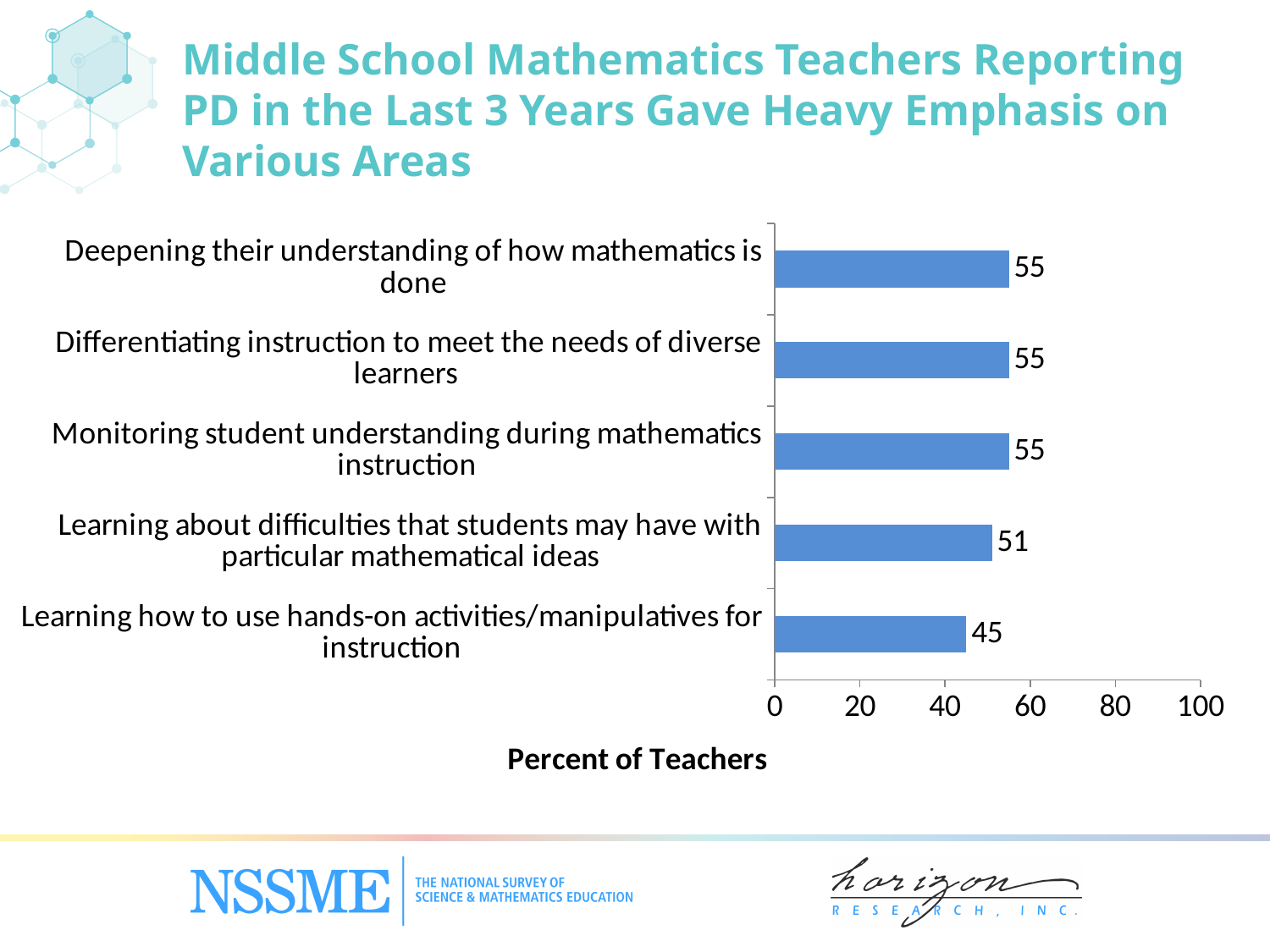
How many areas are shown in the chart? 5 Which area has the lowest percent of teachers? Learning how to use hands-on activities/manipulatives for instruction Is the value for learning how to use hands-on activities/manipulatives for instruction greater or less than 60? less What kind of chart is shown on the slide? Bar chart What is the difference between the value for differentiating instruction to meet the needs of diverse learners and the value for learning how to use hands-on activities/manipulatives for instruction? 10 What percent of teachers reported heavy emphasis on learning how to use hands-on activities/manipulatives for instruction? 45 What is the difference between the value for monitoring student understanding during mathematics instruction and the value for learning about difficulties that students may have with particular mathematical ideas? 4 What percent of teachers reported heavy emphasis on monitoring student understanding during mathematics instruction? 55 What is the value for learning about difficulties that students may have with particular mathematical ideas? 51 What is the label of the horizontal axis? Percent of Teachers Which is larger: the value for learning about difficulties that students may have with particular mathematical ideas or the value for learning how to use hands-on activities/manipulatives for instruction? Learning about difficulties that students may have with particular mathematical ideas What is the value for deepening their understanding of how mathematics is done? 55